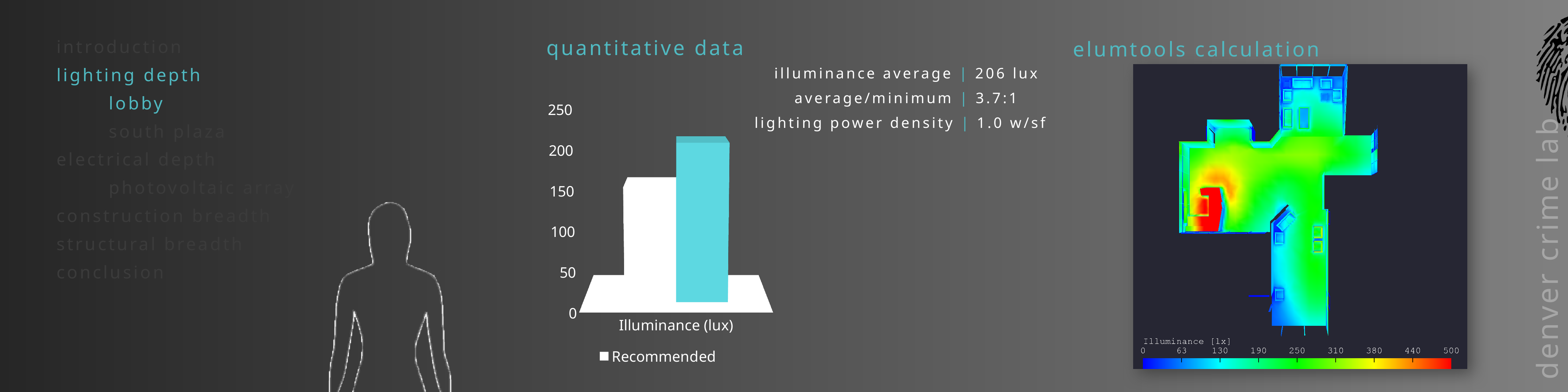
How many series does the legend of the bar chart list? 1 In the bar chart, is the white Recommended bar greater or less than 200? less In the bar chart, is the teal bar greater or less than 150? greater How many categories are shown on the x axis of the bar chart? 1 What kind of chart is shown under the heading "quantitative data"? bar chart What series name appears in the legend of the bar chart? Recommended In the bar chart, which bar is taller, the white Recommended bar or the teal bar? the teal bar What is the highest value shown on the y axis of the bar chart? 250 What is the category label on the x axis of the bar chart? Illuminance (lux) In the bar chart, is the teal bar greater or less than 250? less